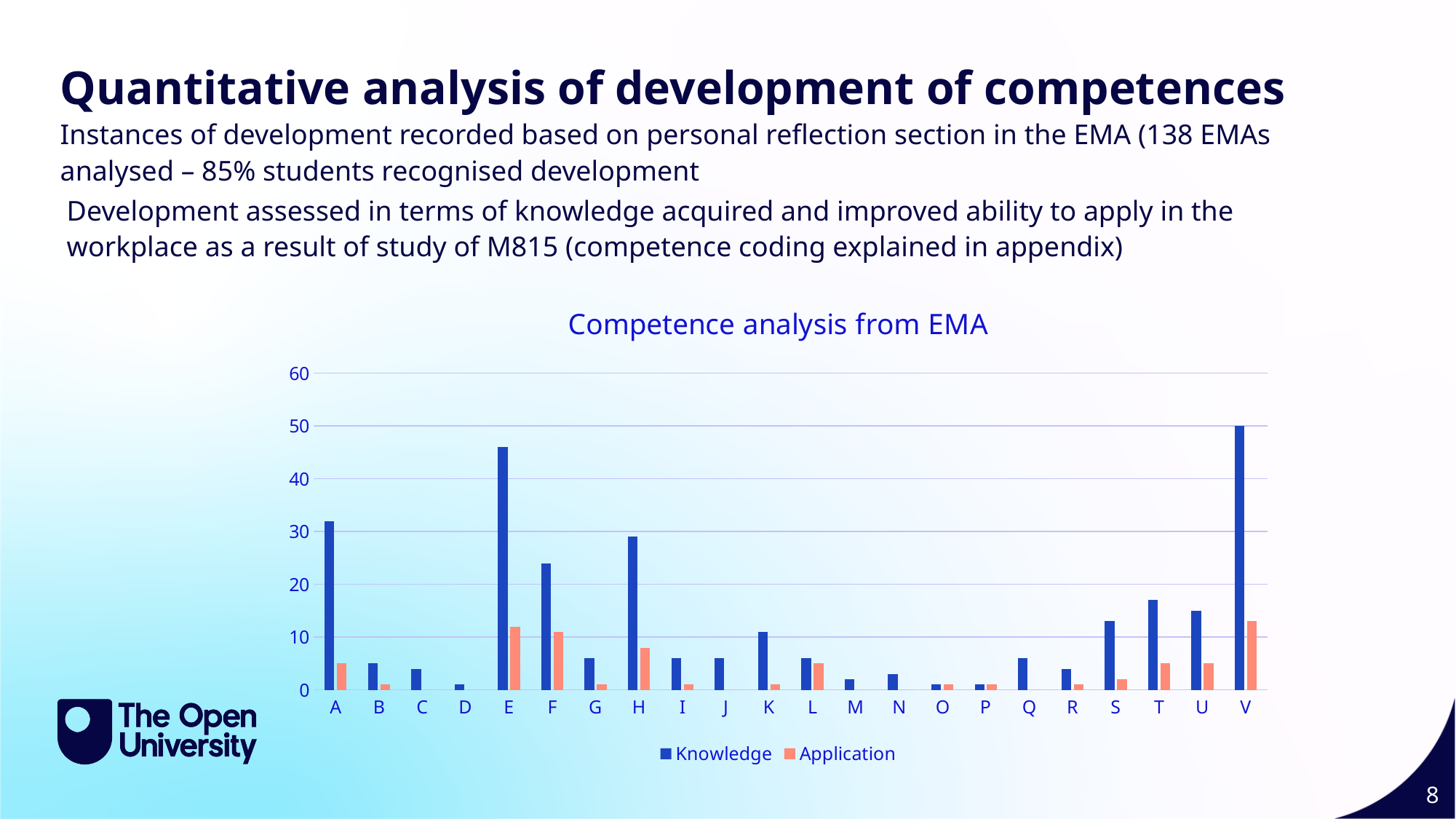
What kind of chart is shown on the slide? bar chart How many categories are shown on the x axis of the chart? 22 How many series does the chart legend list? 2 Is the Application value for E greater or less than 10? greater Is the Knowledge value for T greater or less than 20? less Is the Knowledge value for E greater or less than 40? greater Which category has the highest Knowledge value? V Which has the larger Knowledge value, H or F? H What is the title of the chart? Competence analysis from EMA Which series is shown in blue in the chart legend? Knowledge Which has the larger Knowledge value, E or A? E